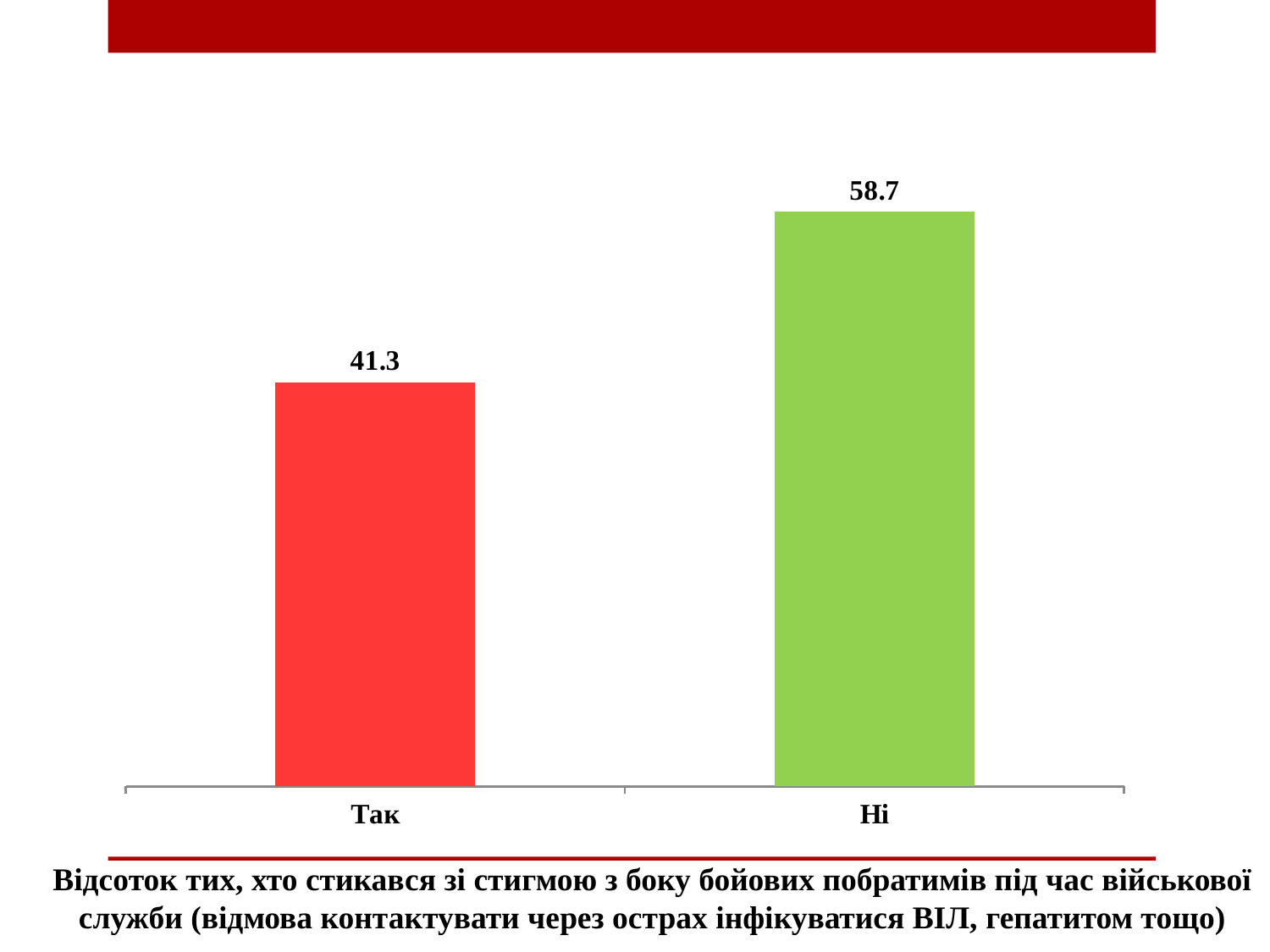
Which category has the lowest value? Так What colour is the bar for "Ні"? Green What is the value for "Ні"? 58.7 What colour is the bar for "Так"? Red Which category has the highest value? Ні How many categories are shown on the x axis? 2 Which is larger, the value for "Так" or the value for "Ні"? Ні What is the total of the two bar values? 100 What is the value for "Так"? 41.3 What kind of chart is shown on the slide? Bar chart What is the difference between the values for "Ні" and "Так"? 17.4